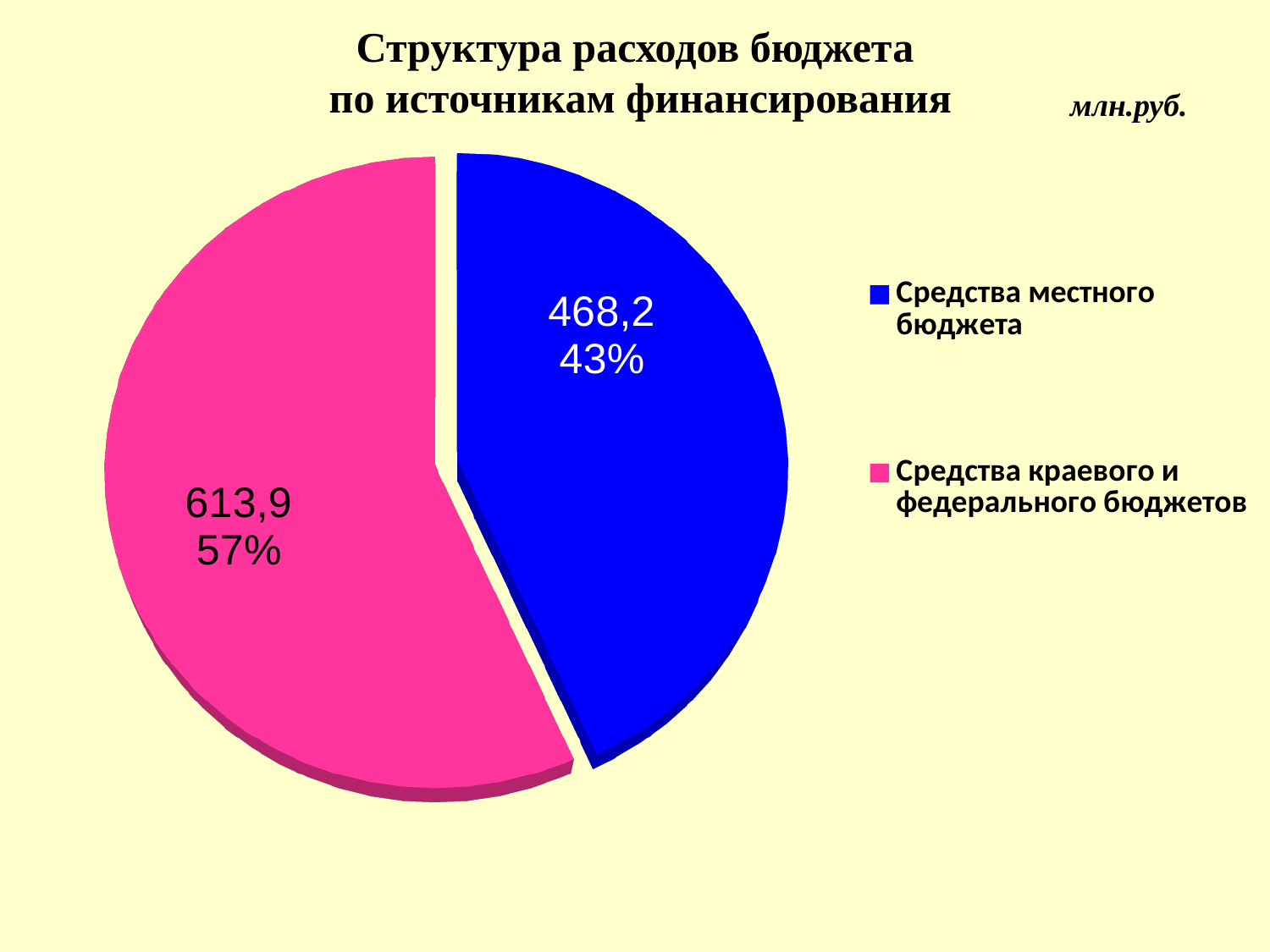
What type of chart is shown on the slide? pie chart Which category has the smallest slice? Средства местного бюджета What share of the pie does Средства краевого и федерального бюджетов represent? 57% Which category has the largest slice? Средства краевого и федерального бюджетов What colour is the slice for Средства местного бюджета? blue What is the value for Средства краевого и федерального бюджетов? 613,9 Which is larger: Средства местного бюджета or Средства краевого и федерального бюджетов? Средства краевого и федерального бюджетов What is the difference between the values for Средства краевого и федерального бюджетов and Средства местного бюджета? 145,7 What share of the pie does Средства местного бюджета represent? 43% What is the title of the chart? Структура расходов бюджета по источникам финансирования How many categories does the pie chart have? 2 What is the value for Средства местного бюджета? 468,2